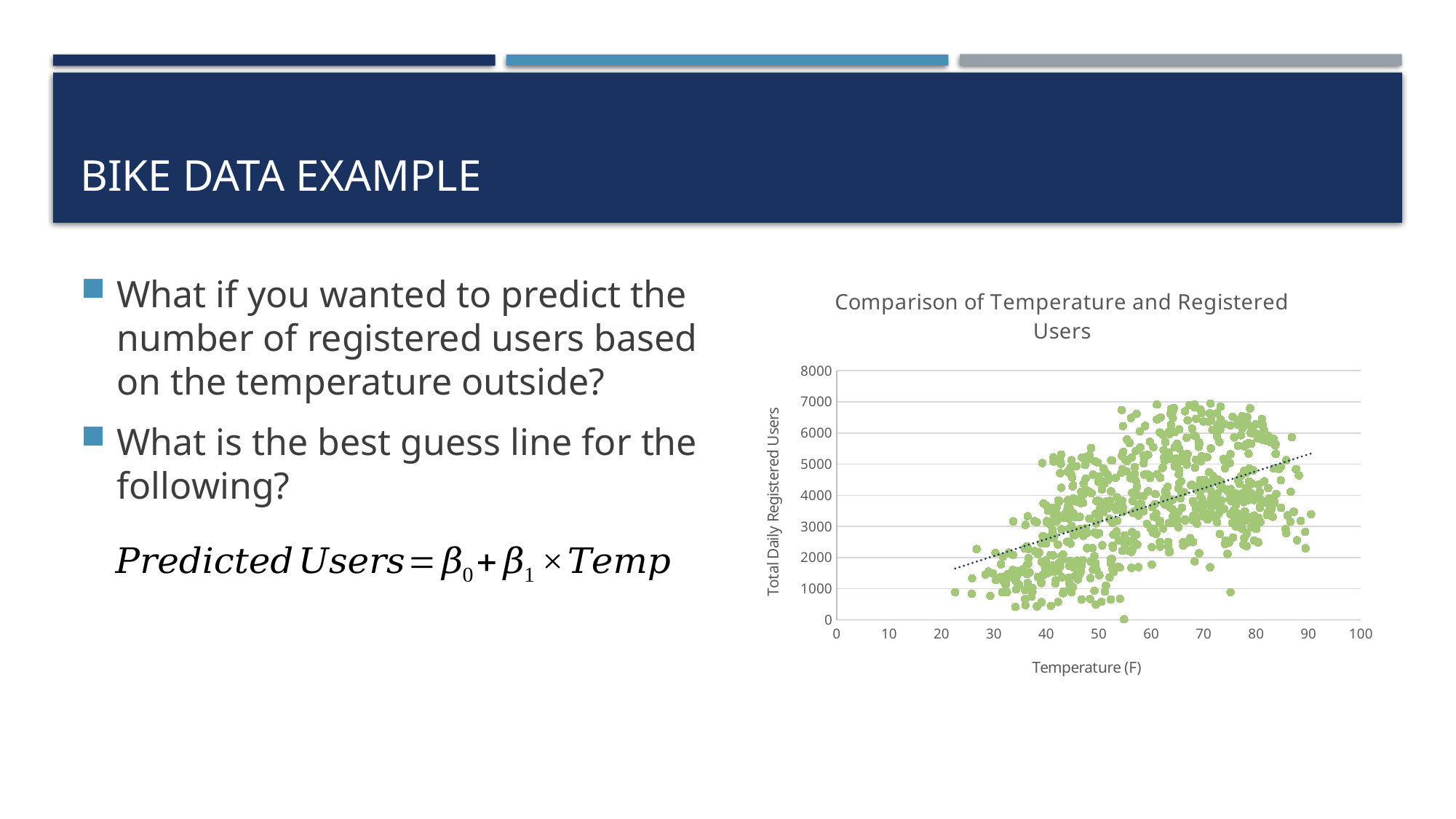
What kind of chart is shown on the slide? scatter chart What is the title of the chart? Comparison of Temperature and Registered Users Does the dotted trend line on the chart slope upward or downward from left to right? upward What is the label of the x axis of the chart? Temperature (F) Is the highest temperature at which a point is plotted greater or less than 80? greater Is the lowest temperature at which a point is plotted greater or less than 30? less As temperature increases along the x axis, do the registered user values generally rise or fall? rise Is the highest plotted value of Total Daily Registered Users greater or less than 6000? greater